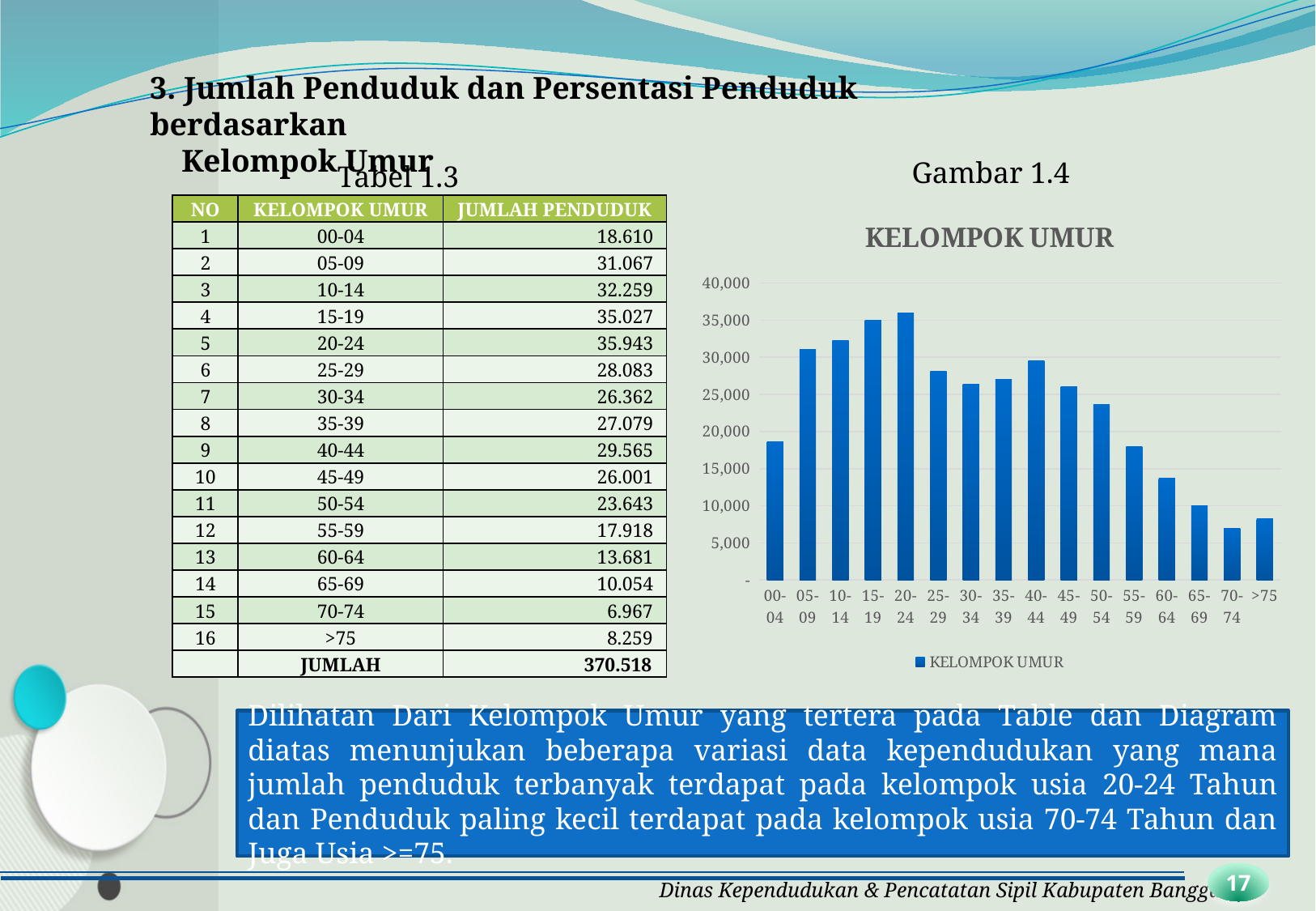
In the KELOMPOK UMUR chart, which age group has the shortest bar? 70-74 In the KELOMPOK UMUR chart, which bar is taller: 45-49 or 50-54? 45-49 In the KELOMPOK UMUR chart, do the values generally rise or fall from the 20-24 group to the 70-74 group? fall What type of chart is shown in Gambar 1.4? bar chart In the KELOMPOK UMUR chart, is the value for 00-04 greater or less than 20,000? less How many age-group categories are plotted on the x axis of the KELOMPOK UMUR chart? 16 In the KELOMPOK UMUR chart, is the value for 60-64 greater or less than 15,000? less How many series does the legend of the KELOMPOK UMUR chart list? 1 In the KELOMPOK UMUR chart, which age group has the tallest bar? 20-24 In the KELOMPOK UMUR chart, is the value for 05-09 greater or less than 30,000? greater What is the title of the chart in Gambar 1.4? KELOMPOK UMUR